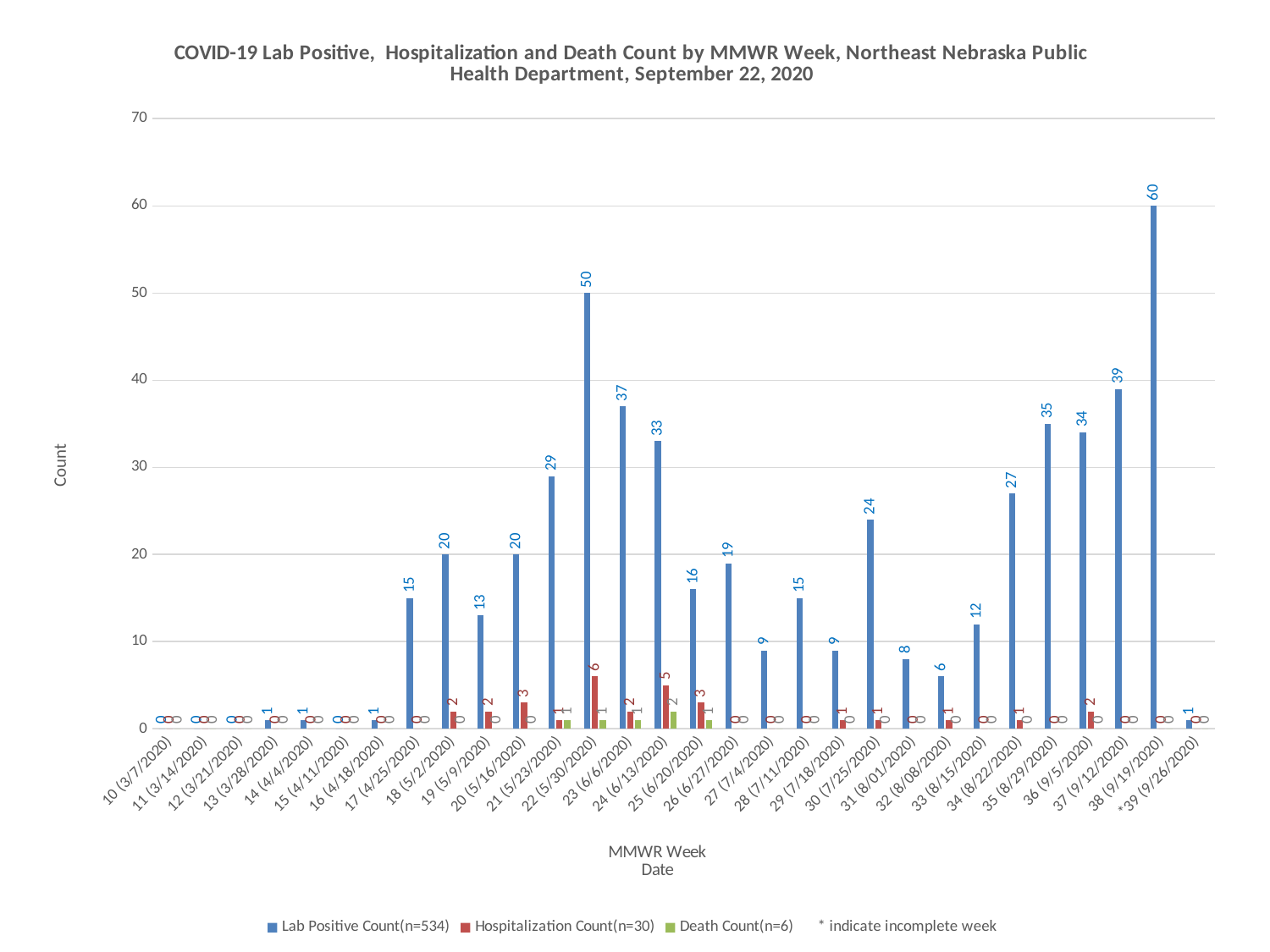
Which colour represents the Death Count series? green What is the Hospitalization Count for MMWR week 22 (5/30/2020)? 6 What kind of chart is shown on the slide? bar chart Is the Lab Positive Count for week 37 (9/12/2020) greater or less than 30? greater What is the difference between the Lab Positive Count for week 38 (9/19/2020) and week 22 (5/30/2020)? 10 Which MMWR week has the highest Lab Positive Count? 38 (9/19/2020) How many series does the legend list? 3 Which is larger, the Lab Positive Count for week 23 (6/6/2020) or week 24 (6/13/2020)? 23 (6/6/2020) What is the Lab Positive Count for MMWR week 38 (9/19/2020)? 60 How many MMWR weeks are shown on the x axis? 30 What is the Death Count for MMWR week 24 (6/13/2020)? 2 Which MMWR week has the highest Hospitalization Count? 22 (5/30/2020)